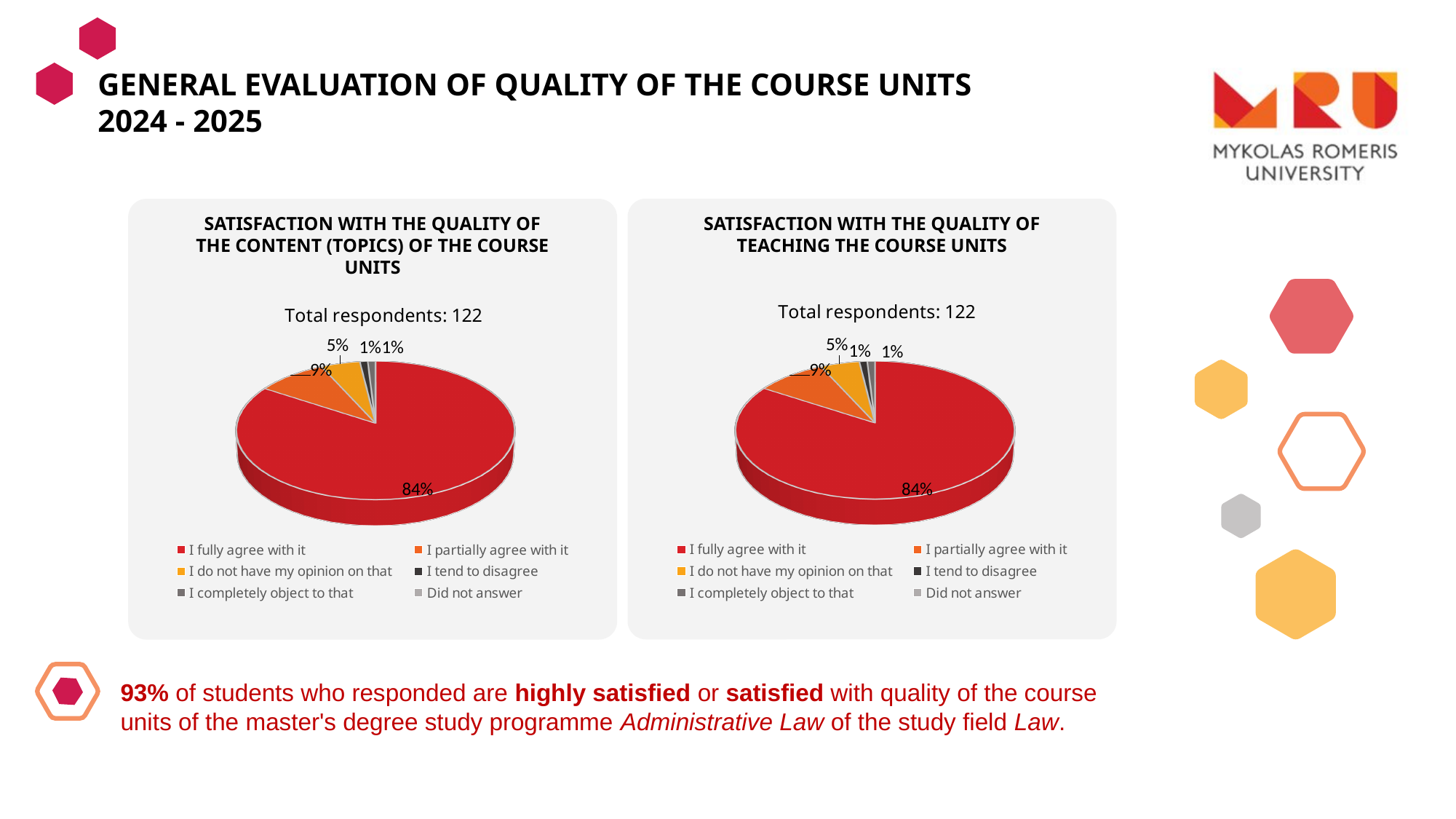
In the right chart (satisfaction with the quality of teaching the course units), what share of respondents chose 'I partially agree with it'? 9% What type of chart is used for satisfaction with the quality of the content of the course units? Pie chart In the left chart (satisfaction with the quality of the content of the course units), what share of respondents chose 'I do not have my opinion on that'? 5% In the left chart (satisfaction with the quality of the content of the course units), what is the difference in percentage points between 'I partially agree with it' and 'I do not have my opinion on that'? 4 percentage points How many total respondents are reported for the right chart (satisfaction with the quality of teaching the course units)? 122 In the right chart (satisfaction with the quality of teaching the course units), which response has the largest share? I fully agree with it In the left chart (satisfaction with the quality of the content of the course units), what share of respondents chose 'I fully agree with it'? 84% How many response categories does the legend of the right chart (satisfaction with the quality of teaching the course units) list? 6 What is the title of the left chart? Satisfaction with the quality of the content (topics) of the course units In the left chart (satisfaction with the quality of the content of the course units), which is larger: 'I partially agree with it' or 'I do not have my opinion on that'? I partially agree with it In the right chart (satisfaction with the quality of teaching the course units), what is the difference in percentage points between 'I fully agree with it' and 'I partially agree with it'? 75 percentage points